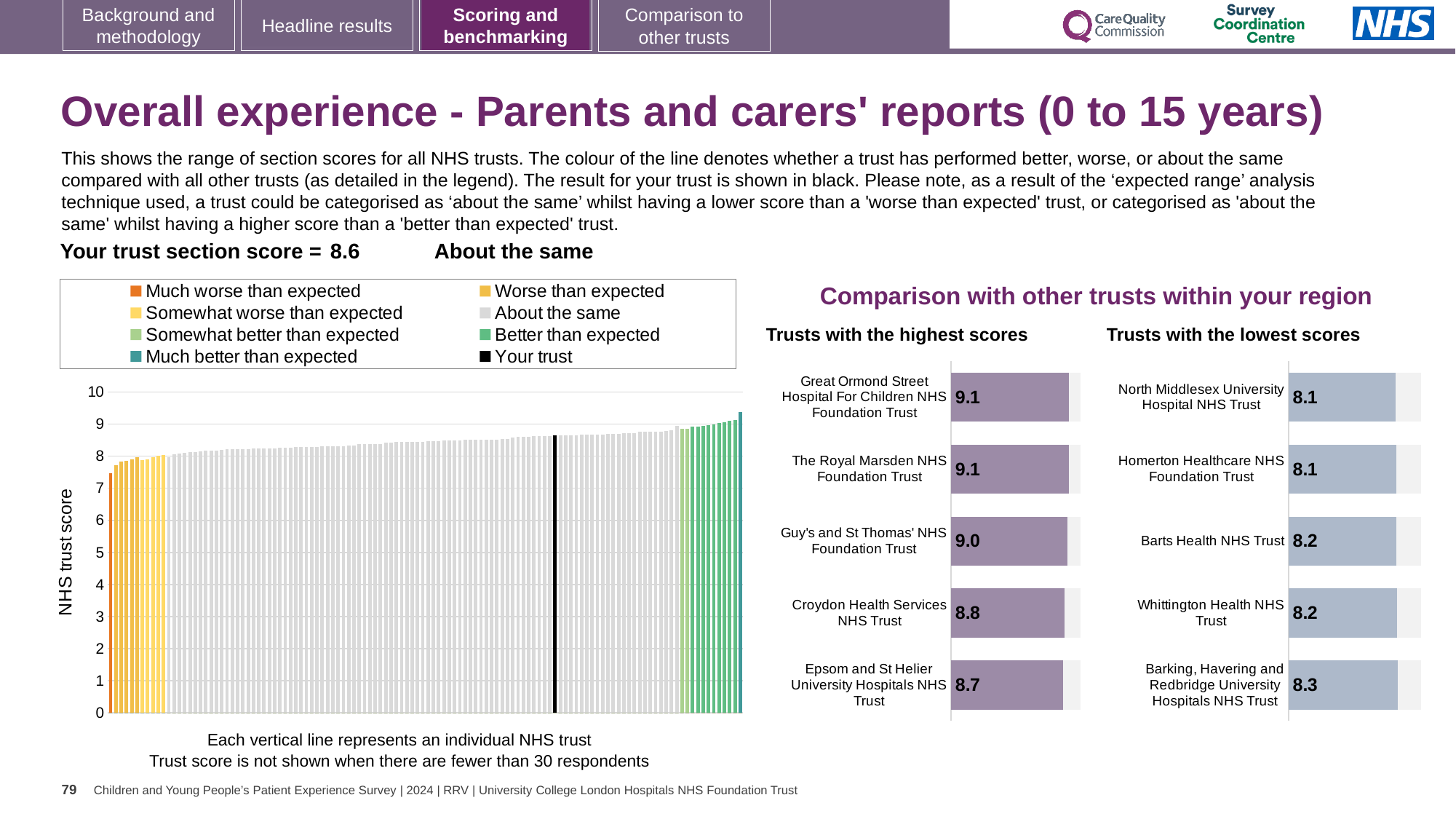
In the 'Trusts with the highest scores' chart, what is the difference between the scores of Great Ormond Street Hospital For Children NHS Foundation Trust and Epsom and St Helier University Hospitals NHS Trust? 0.4 In the 'Trusts with the highest scores' chart, which trust has the lowest score? Epsom and St Helier University Hospitals NHS Trust In the 'Trusts with the highest scores' chart, which has the larger score: Guy's and St Thomas' NHS Foundation Trust or Croydon Health Services NHS Trust? Guy's and St Thomas' NHS Foundation Trust In the 'Trusts with the lowest scores' chart, which trust has the highest score? Barking, Havering and Redbridge University Hospitals NHS Trust In the 'Trusts with the highest scores' chart, what is the score for Croydon Health Services NHS Trust? 8.8 In the main chart on the left showing all NHS trusts, what is the section score for your trust (the black bar)? 8.6 In the 'Trusts with the lowest scores' chart, what is the score for Barts Health NHS Trust? 8.2 In the 'Trusts with the highest scores' chart, what is the score for Guy's and St Thomas' NHS Foundation Trust? 9.0 In the 'Trusts with the lowest scores' chart, what is the difference between the scores of Barking, Havering and Redbridge University Hospitals NHS Trust and North Middlesex University Hospital NHS Trust? 0.2 What kind of chart is the main chart on the left showing all NHS trusts? Bar chart In the main chart on the left showing all NHS trusts, how many entries does the legend list? 8 In the 'Trusts with the lowest scores' chart, how many trusts are shown? 5